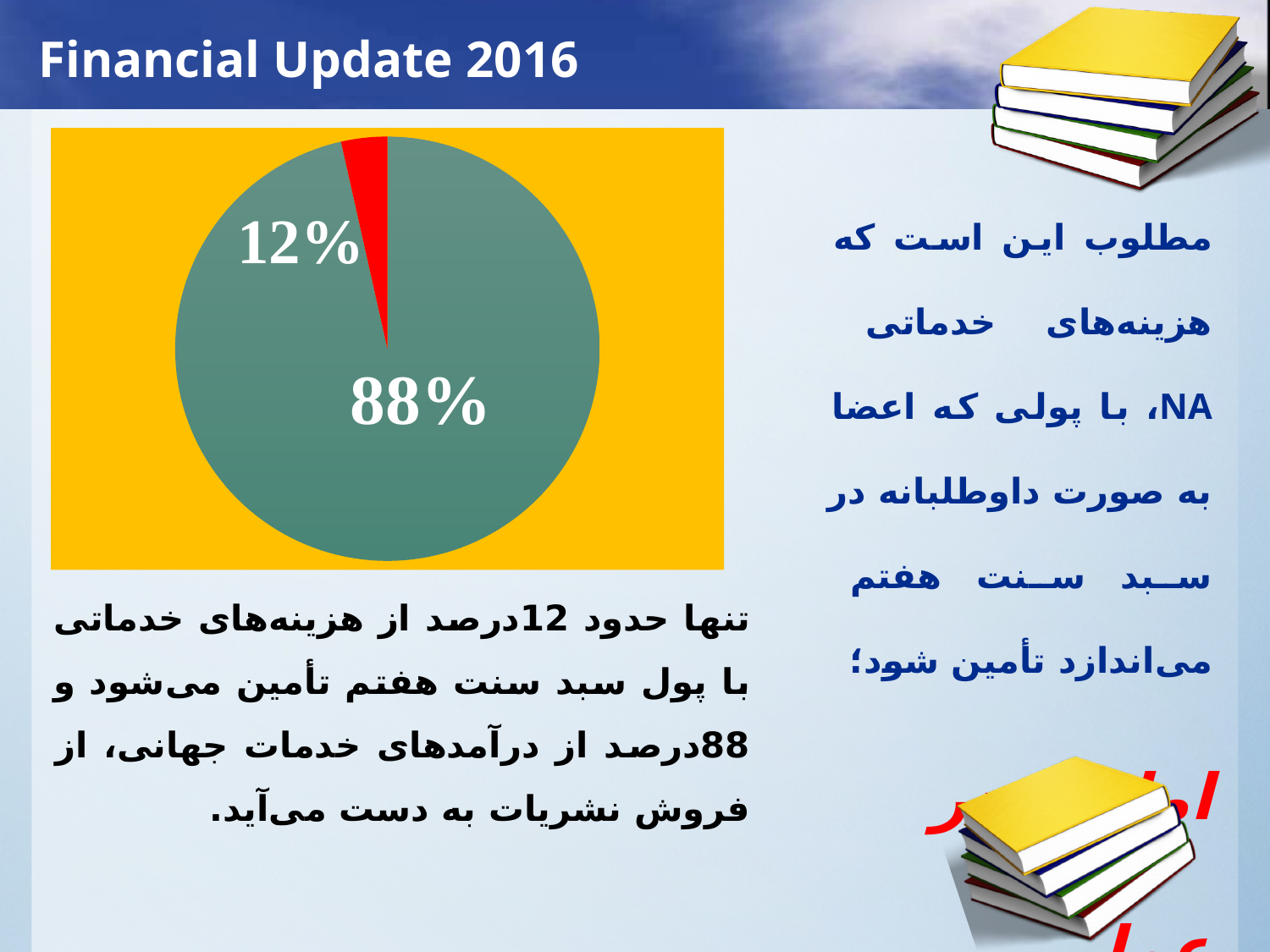
What share of the pie does the red slice represent? 12% What is the difference between the two slices of the pie chart? 76 percentage points What is the title shown at the top of the slide? Financial Update 2016 What percentage is shown for the red slice of the pie chart? 12% What kind of chart is shown on the slide? pie chart What percentage is shown for the green slice of the pie chart? 88% What colour is the 12% slice of the pie chart? red What do the two slices of the pie chart add up to? 100% Which slice of the pie chart is the largest? 88% Which slice is larger, the red slice or the green slice? the green slice How many slices does the pie chart have? 2 Which slice of the pie chart is the smallest? 12%